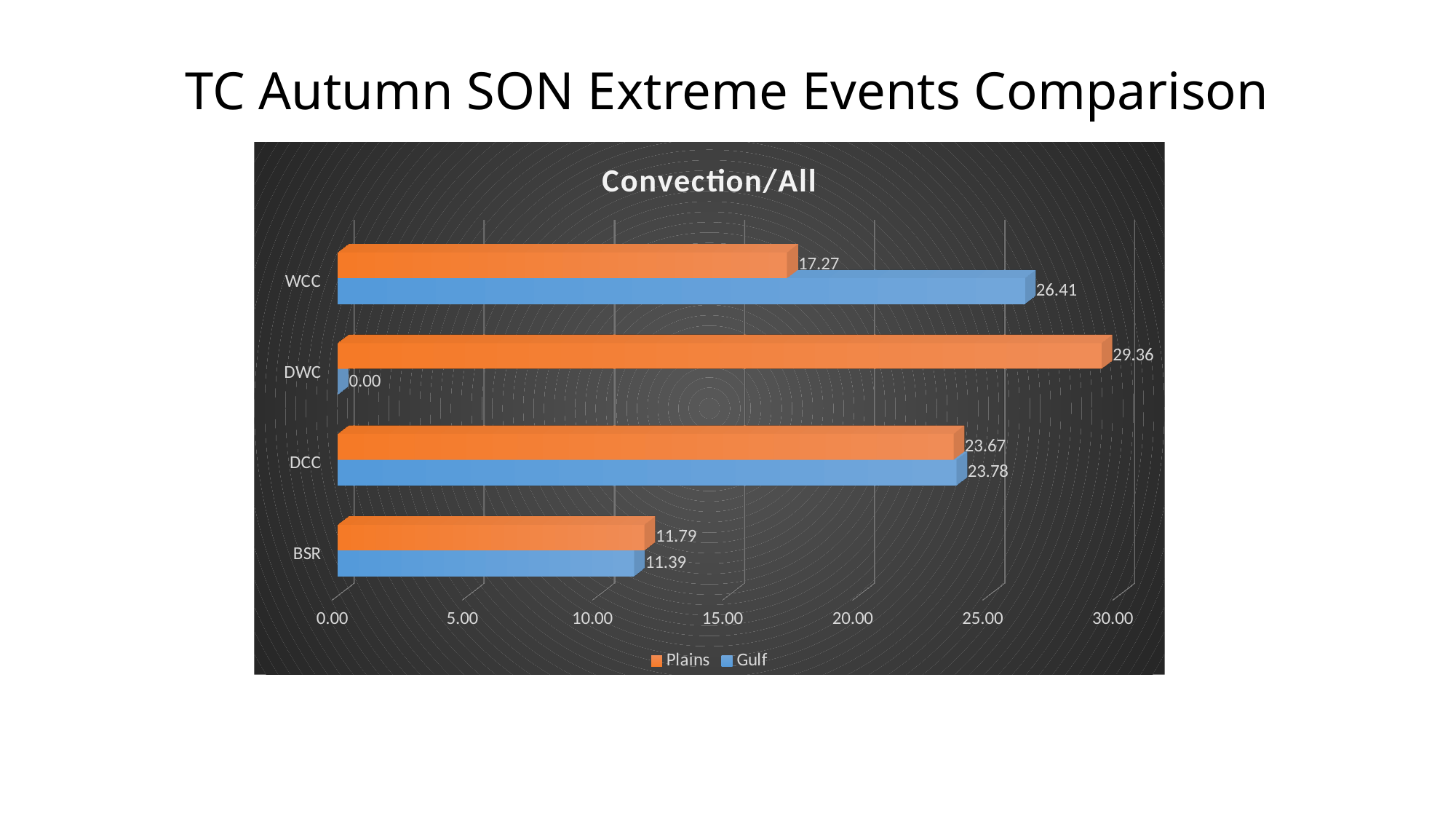
How many categories are shown on the chart? 4 What is the Plains value for WCC? 17.27 What is the difference between the Gulf and Plains values for WCC? 9.14 What is the Plains value for BSR? 11.79 Which category has the highest Gulf value? WCC What is the Gulf value for DCC? 23.78 What is the Gulf value for DWC? 0.00 Which category has the highest Plains value? DWC How many series does the legend list? 2 What type of chart is shown on the slide? Bar chart Which category has the lowest Gulf value? DWC For WCC, which series has the larger value, Plains or Gulf? Gulf